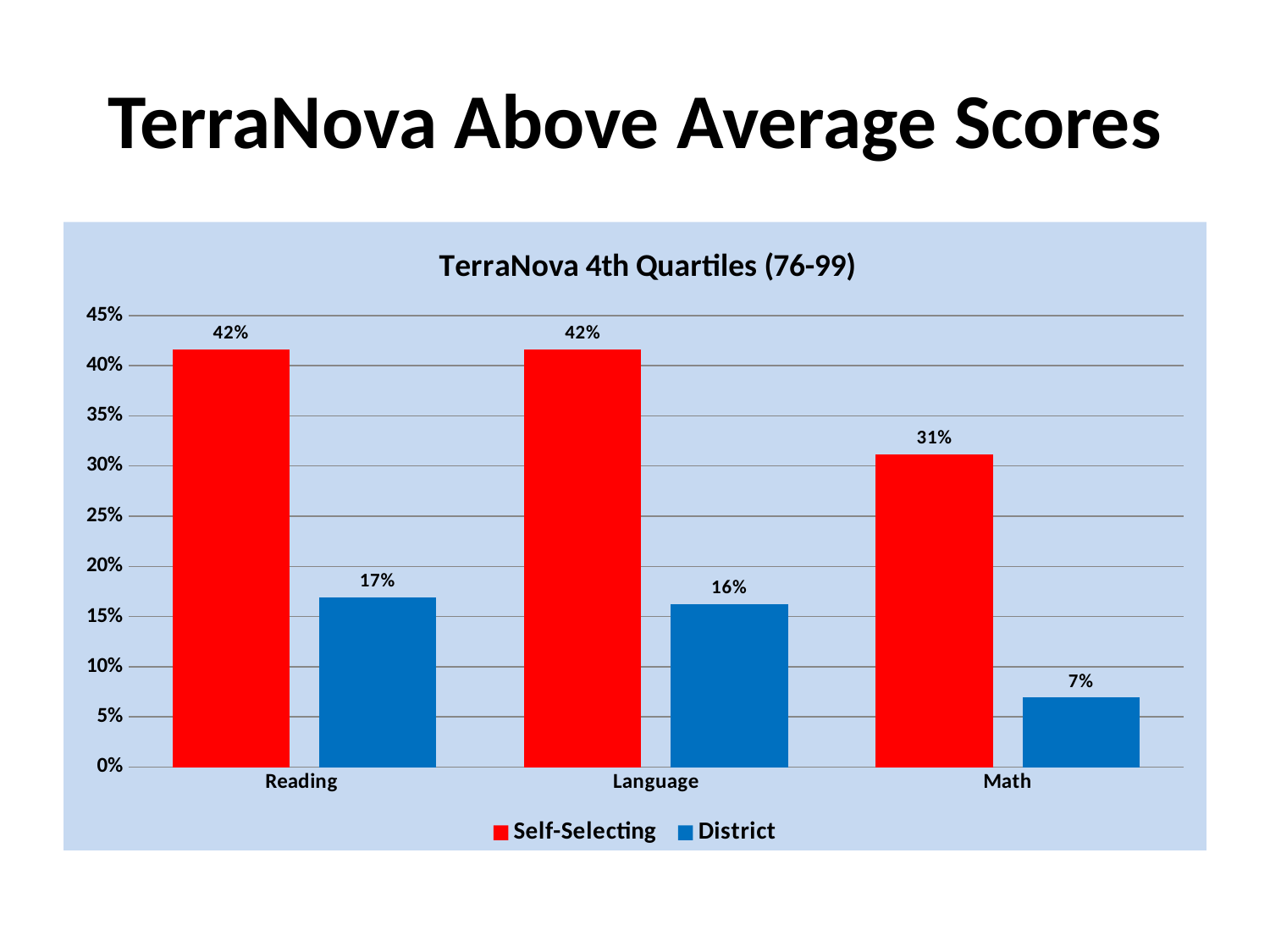
Which is larger, the District value for Reading or the District value for Math? Reading What kind of chart is shown? Bar chart What is the District value for Language? 16% How many categories are shown on the x axis? 3 What is the title of the chart? TerraNova 4th Quartiles (76-99) Which category has the lowest District value? Math How many series does the legend list? 2 What is the difference between the Self-Selecting and District values for Reading? 25% What is the difference between the Self-Selecting and District values for Math? 24% Which category has the lowest Self-Selecting value? Math What is the District value for Math? 7% What is the Self-Selecting value for Reading? 42%